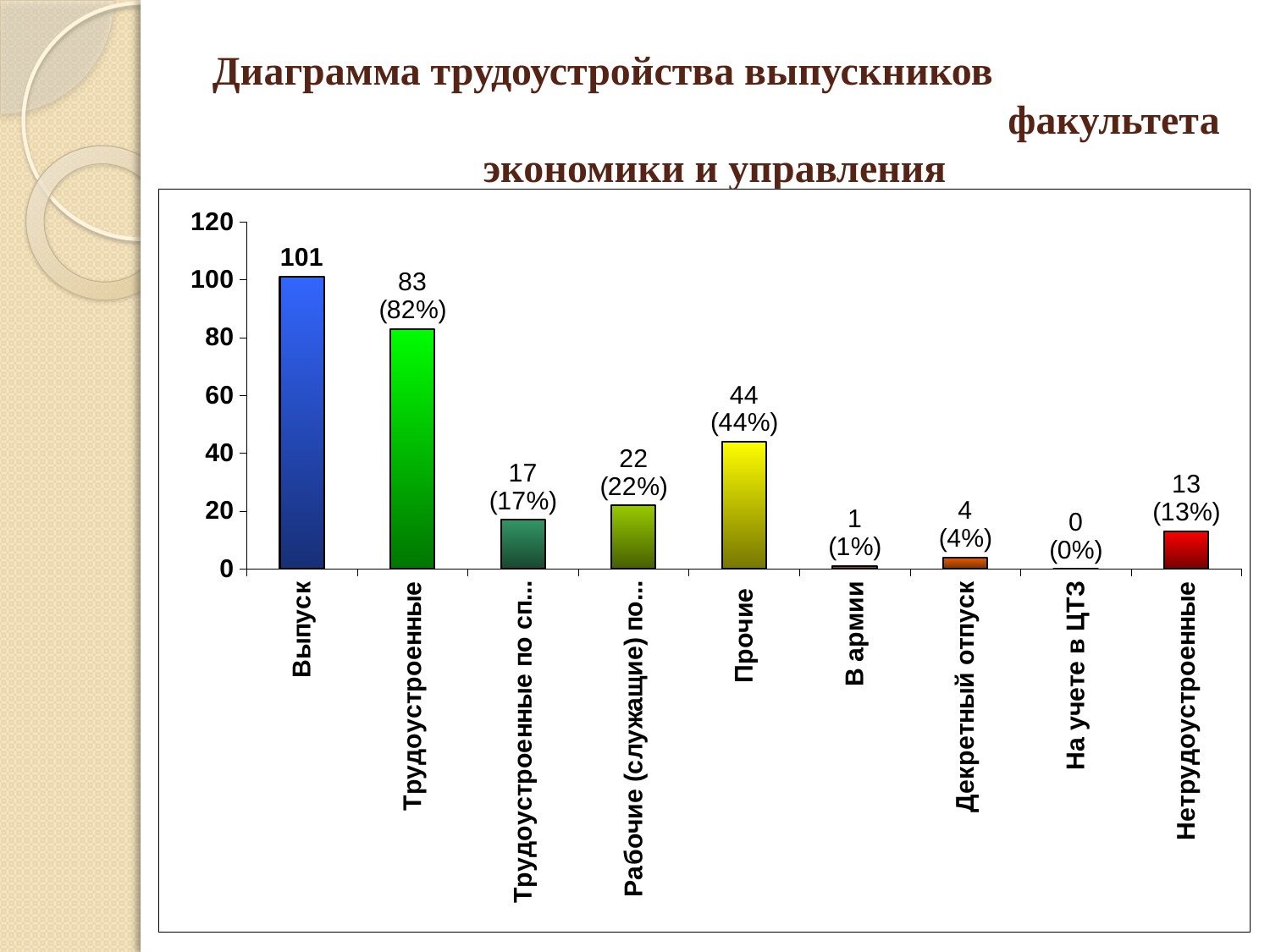
What kind of chart is shown on the slide? Bar chart How many categories are shown on the x axis? 9 What is the value for Выпуск? 101 What value is shown for Нетрудоустроенные? 13 (13%) Which category has the lowest value? На учете в ЦТЗ Which is larger, the value for Нетрудоустроенные or the value for Декретный отпуск? Нетрудоустроенные What value is shown for Трудоустроенные? 83 (82%) What is the difference between the values for Выпуск and Трудоустроенные? 18 What value is shown for Прочие? 44 (44%) Which category has the highest value? Выпуск What value is shown for Декретный отпуск? 4 (4%) What is the highest value shown on the y axis? 120